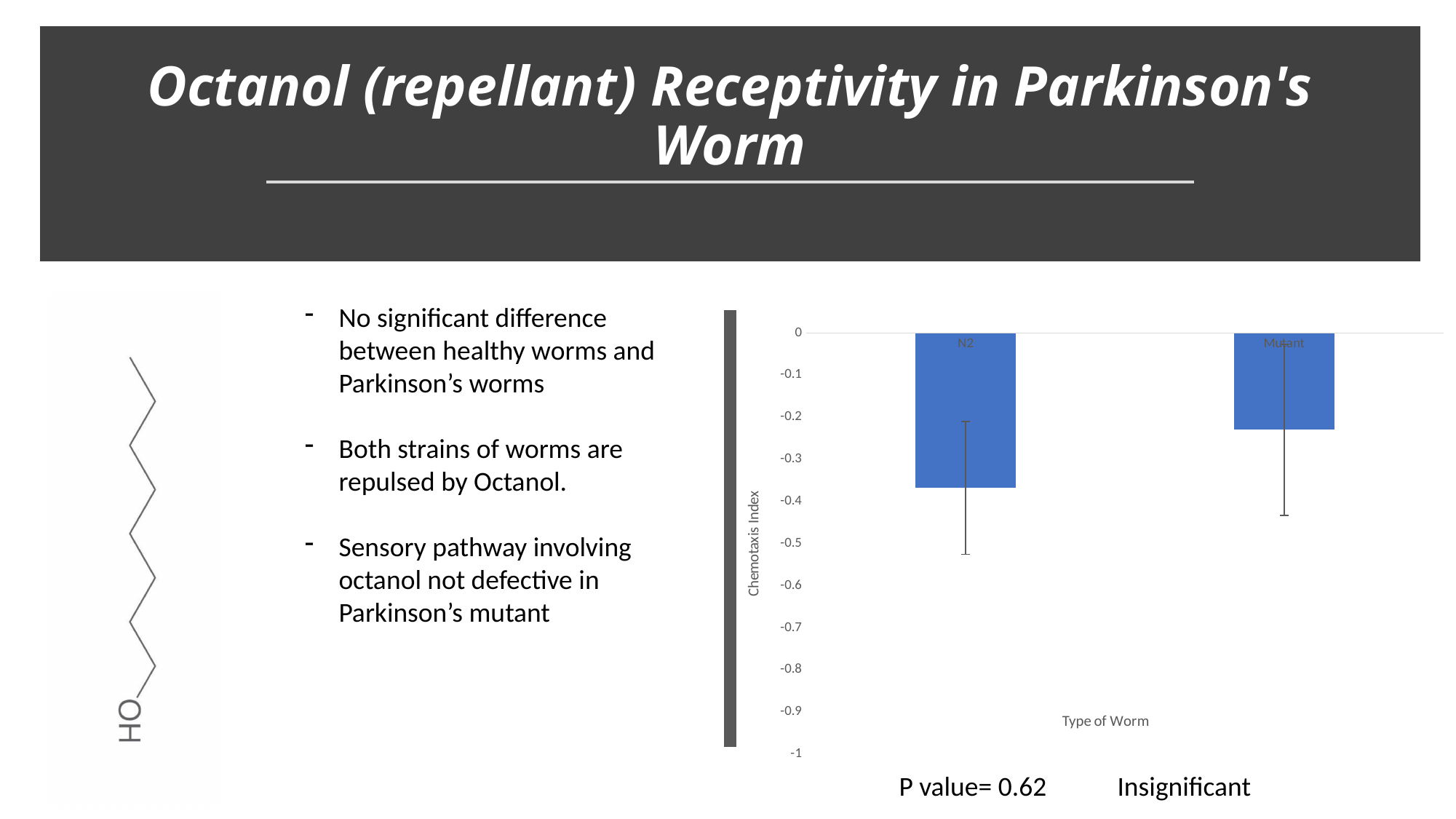
Which category has the lowest (most negative) chemotaxis index? N2 Is the chemotaxis index for Mutant greater or less than -0.1? less What is the title of the horizontal axis of the chart? Type of Worm Which bar extends further below zero, N2 or Mutant? N2 Is the chemotaxis index for N2 greater or less than -0.5? greater Which category has the highest chemotaxis index? Mutant What kind of chart is shown on the slide? bar chart What is the title of the vertical axis of the chart? Chemotaxis Index How many categories (types of worm) are plotted in the chart? 2 Is the chemotaxis index for Mutant greater or less than -0.3? greater Are the plotted chemotaxis index values positive or negative for both worm types? negative